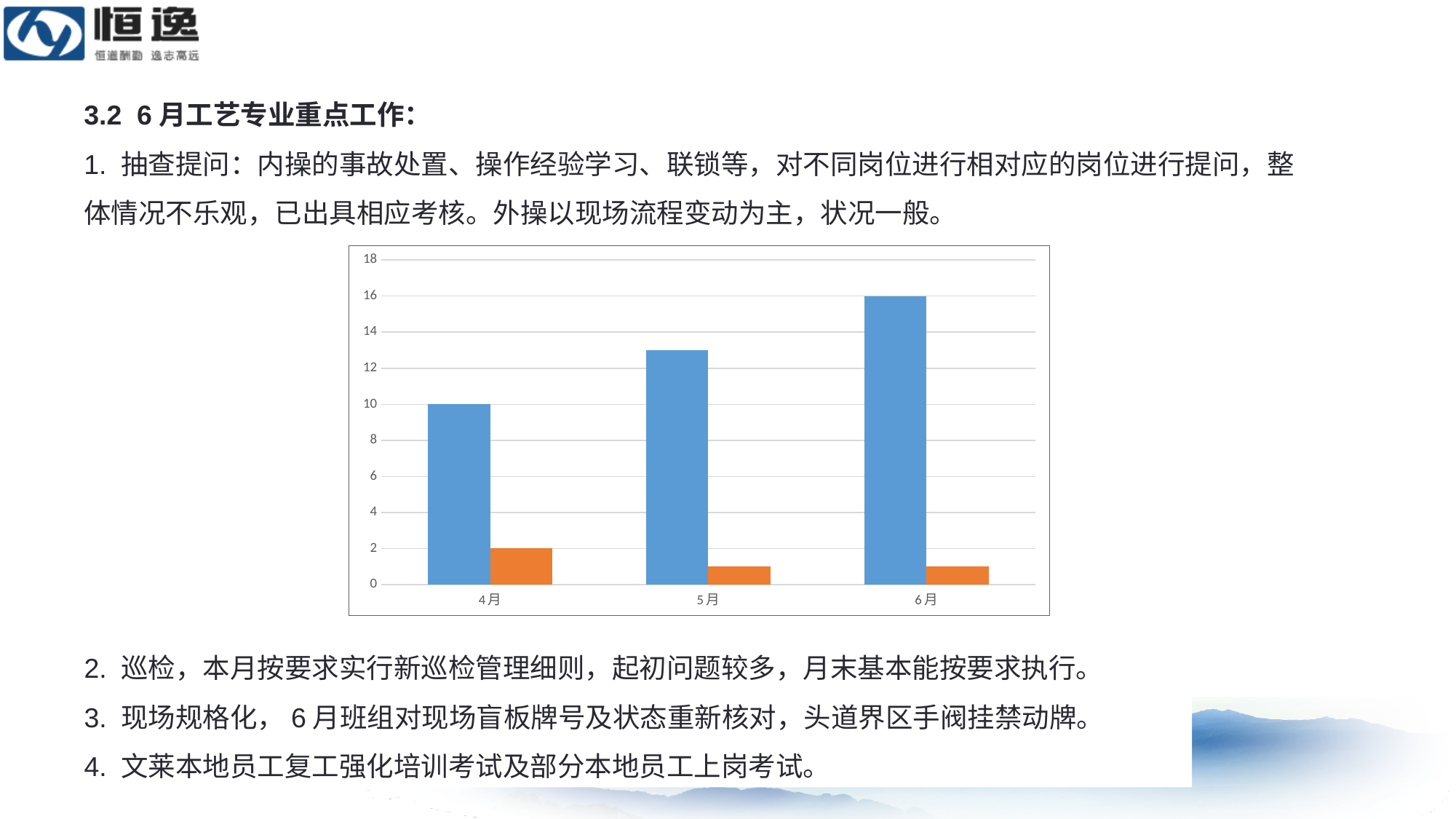
Is the value of the blue bar for 5月 greater or less than 12? greater Is the value of the orange bar for 5月 greater or less than 2? less How many bars are plotted for each month in the chart? 2 What kind of chart is shown on the slide? bar chart What is the value of the orange bar for 4月? 2 What is the value of the blue bar for 6月? 16 What is the difference between the blue bar for 6月 and the blue bar for 4月? 6 How many categories are shown on the x axis of the chart? 3 Which month has the highest blue bar? 6月 What is the value of the blue bar for 4月? 10 Which month has the highest orange bar? 4月 Which month has the lowest blue bar? 4月